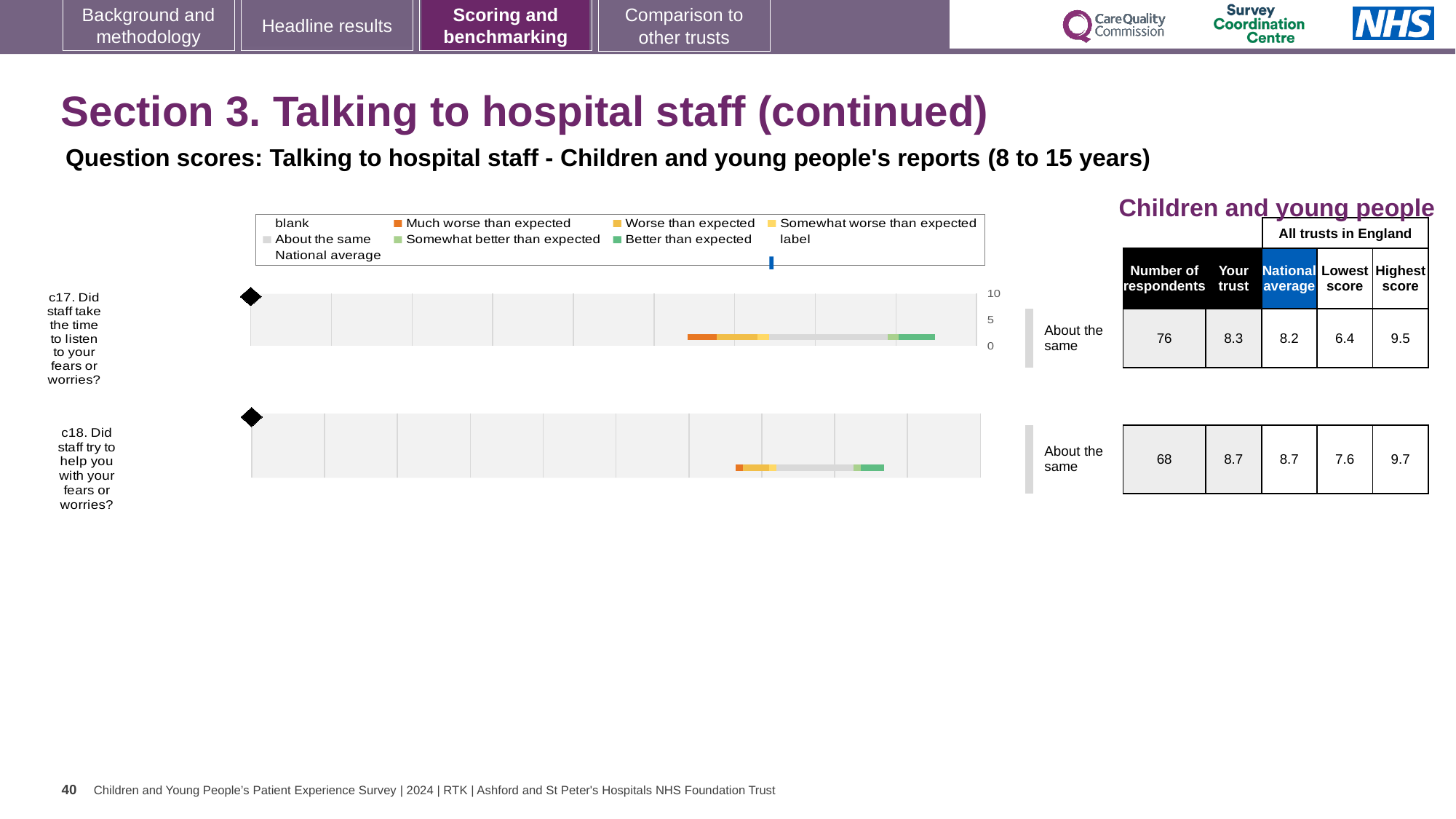
How many more respondents answered c17 than c18? 8 How many questions (c17 and c18) are plotted on the slide? 2 How many respondents answered question c17? 76 Which question has the higher 'Your trust' score, c17 or c18? c18 Is the 'Your trust' score for c17 greater or less than 5 on the chart axis? greater How many entries does the chart legend list? 9 What kind of chart is used to show the question scores for c17 and c18? Bar chart What is the national average score for c18 (Did staff try to help you with your fears or worries)? 8.7 What benchmark category is shown next to the c18 chart? About the same What is the highest score among all trusts in England for c18? 9.7 What is the difference between the highest and lowest trust scores for c17? 3.1 What is the 'Your trust' score for c17 (Did staff take the time to listen to your fears or worries)? 8.3